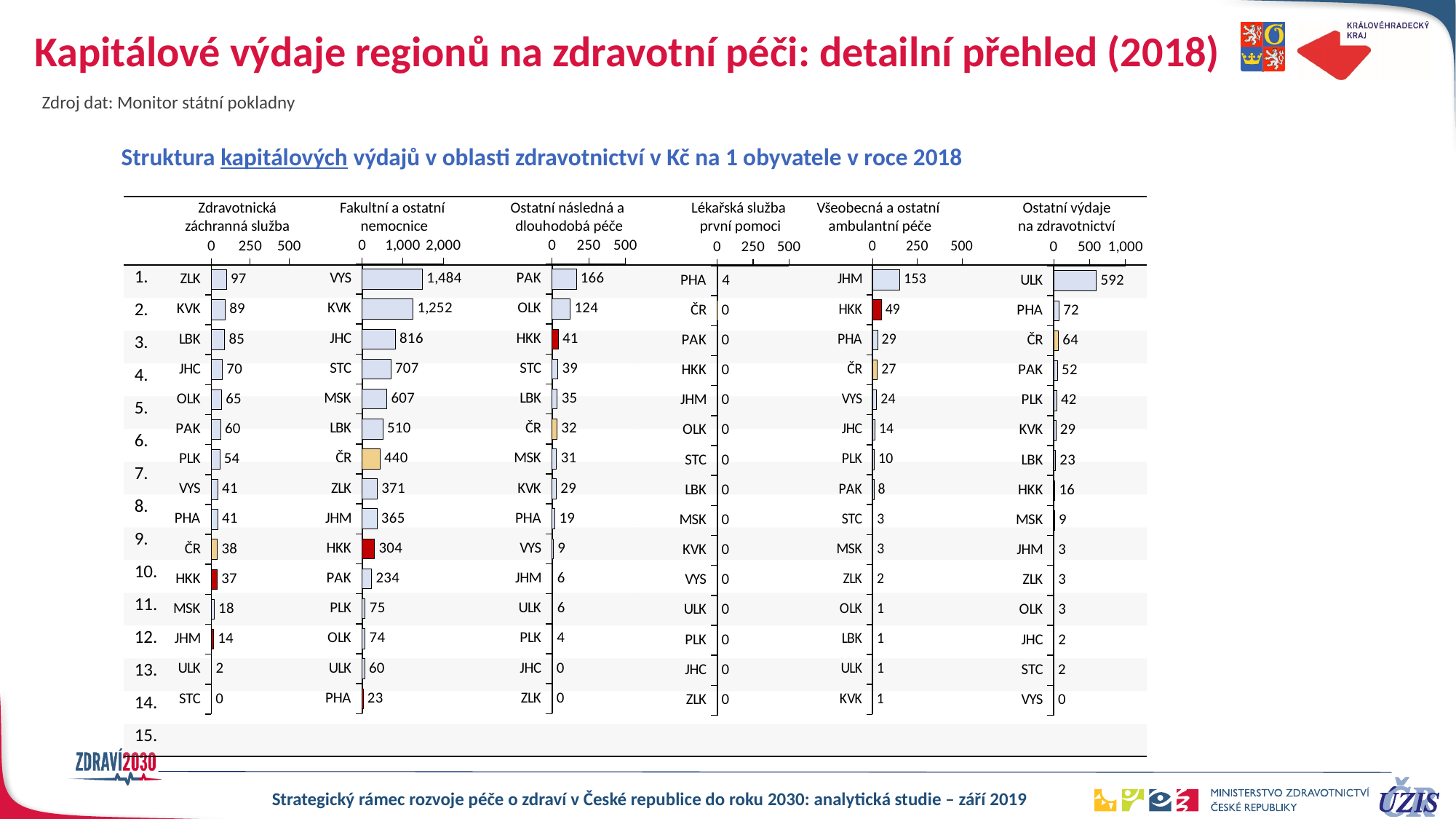
In the 'Fakultní a ostatní nemocnice' chart, what is the value for VYS? 1,484 In the 'Fakultní a ostatní nemocnice' chart, which is larger, the value for JHC or the value for STC? JHC How many categories are listed in the 'Všeobecná a ostatní ambulantní péče' chart? 15 In the 'Zdravotnická záchranná služba' chart, which region has the highest value? ZLK In the 'Ostatní následná a dlouhodobá péče' chart, what is the difference between the values for PAK and OLK? 42 What kind of chart is used for 'Ostatní výdaje na zdravotnictví'? Bar chart In the 'Ostatní výdaje na zdravotnictví' chart, which is larger, the value for PHA or the value for ČR? PHA In the 'Fakultní a ostatní nemocnice' chart, what is the difference between the values for VYS and KVK? 232 In the 'Všeobecná a ostatní ambulantní péče' chart, what is the value for HKK? 49 In the 'Lékařská služba první pomoci' chart, which region has the highest value? PHA In the 'Ostatní výdaje na zdravotnictví' chart, what is the value for ULK? 592 In the 'Zdravotnická záchranná služba' chart, what is the value for ČR? 38